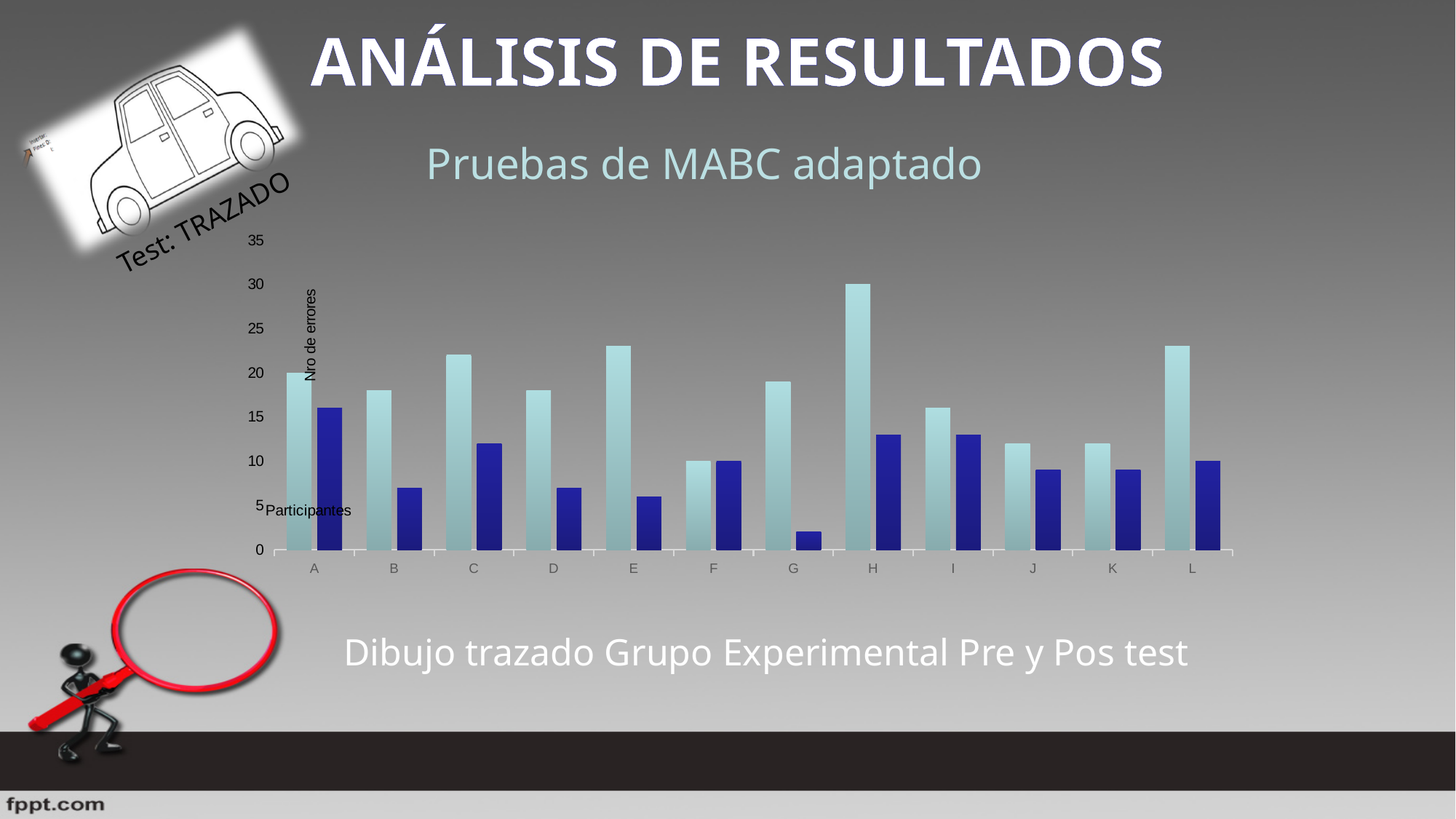
What is the value of the light blue bar for participant H? 30 Which participant has the tallest light blue bar in the chart? H How many participant categories are shown on the x axis of the chart? 12 For participant A, which bar is larger, the light blue bar or the dark blue bar? the light blue bar Which participant has the shortest dark blue bar in the chart? G Is the dark blue bar for participant B greater or less than 10? less What is the value of the light blue bar for participant A? 20 What is the label on the vertical axis of the chart? Nro de errores Is the dark blue bar for participant I greater or less than 10? greater Is the light blue bar for participant E greater or less than 20? greater What kind of chart is shown on the slide? bar chart